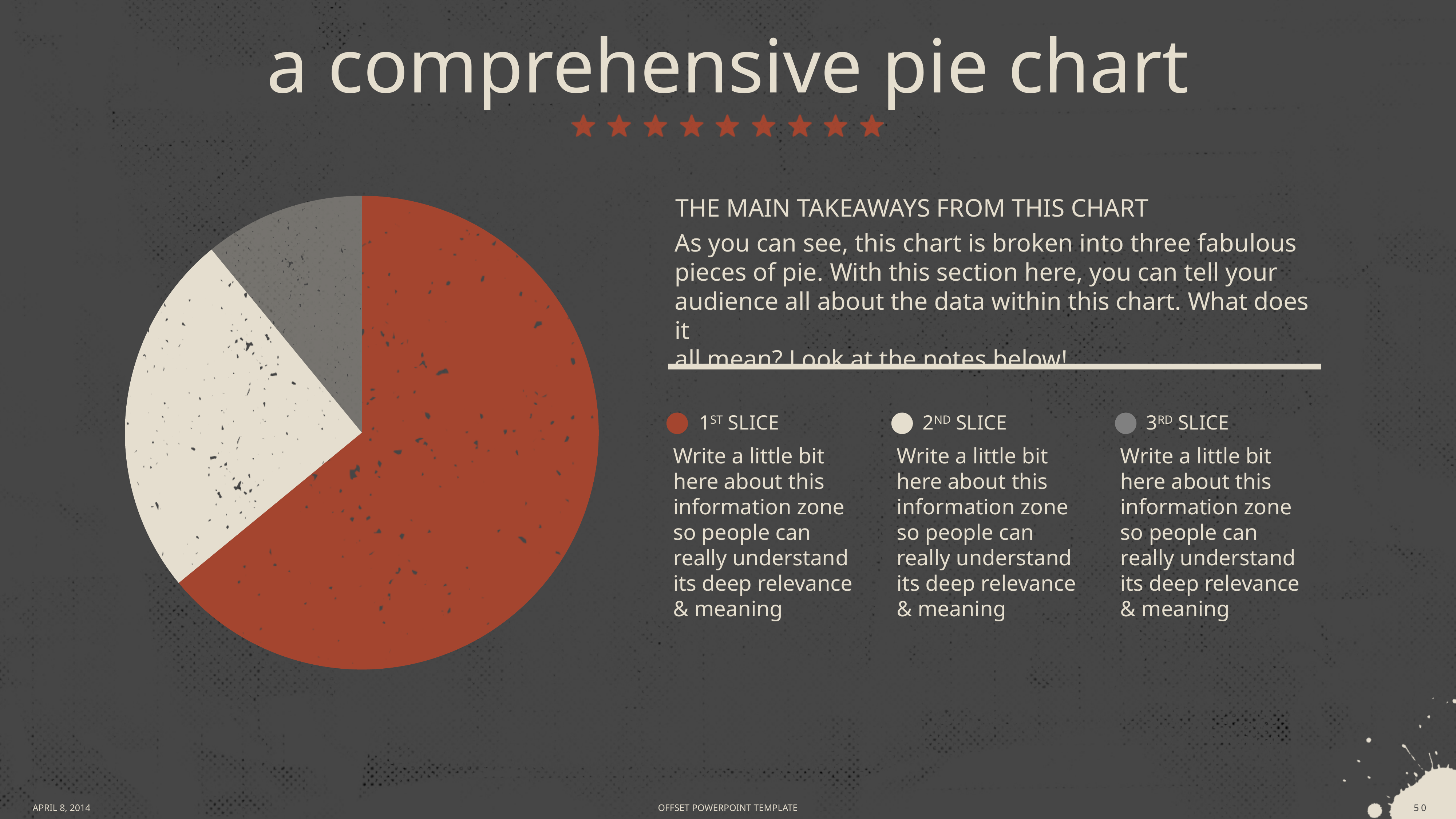
Which is larger in the pie chart, the 1st slice or the 2nd slice? 1st slice What colour is the 1st slice in the pie chart? red Which slice is the smallest in the pie chart? 3rd slice How many slices does the pie chart have? 3 Which is larger in the pie chart, the 2nd slice or the 3rd slice? 2nd slice What kind of chart is shown on the slide? pie chart Which slice is the largest in the pie chart? 1st slice What colour is the 3rd slice in the pie chart? gray Does the 1st slice take up more or less than half of the pie? more